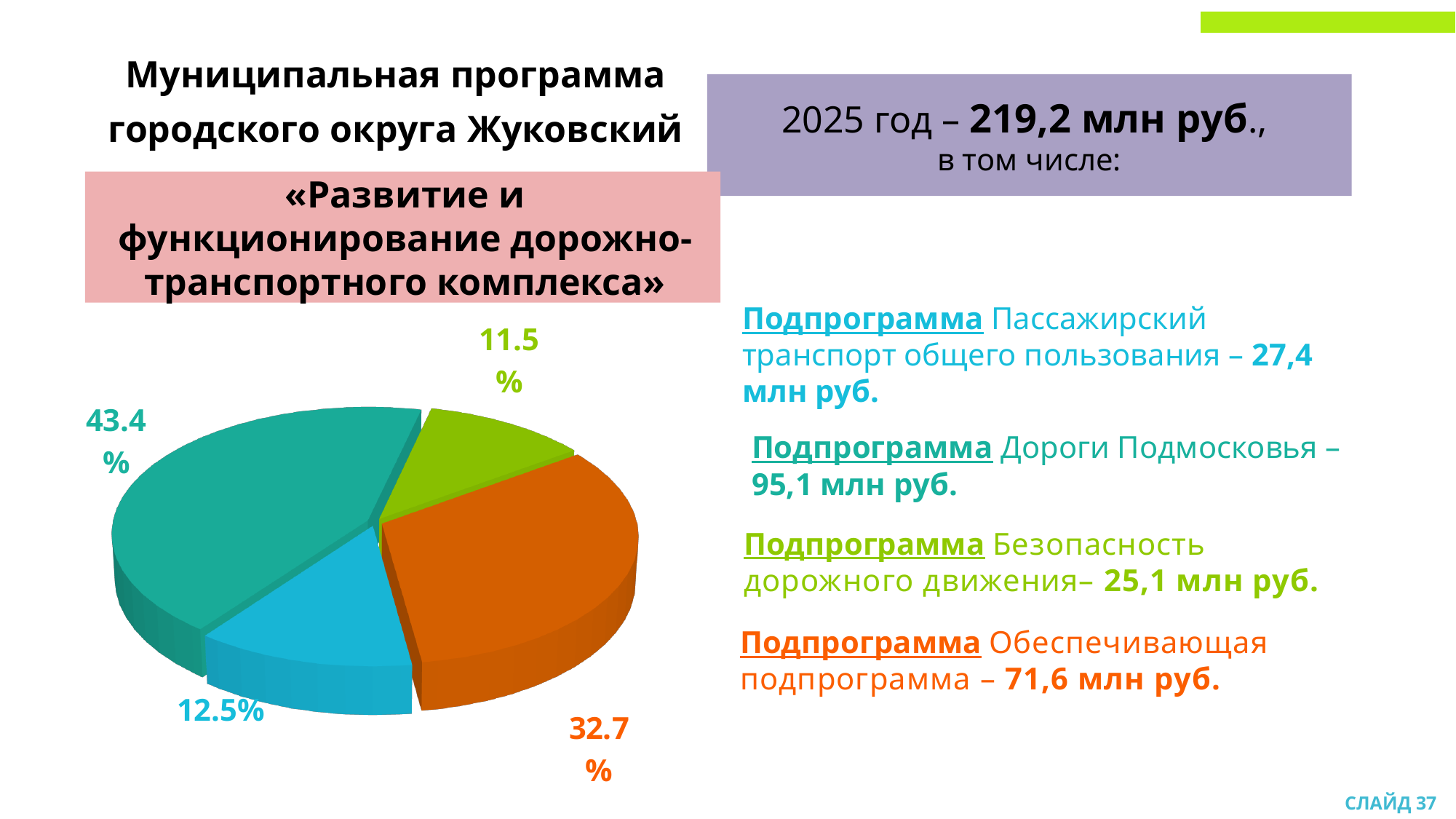
What percentage is shown for the green slice of the pie chart? 11.5% How many slices does the pie chart have? 4 What kind of chart is shown on the slide? pie chart What is the difference in percentage points between the largest slice (43.4%) and the orange slice (32.7%)? 10.7 According to the slide, what is the total programme budget for 2025 that the pie chart breaks down? 219,2 млн руб. What is the smallest share shown in the pie chart? 11.5% What percentage is shown for the light blue (cyan) slice of the pie chart? 12.5% What is the largest share shown in the pie chart? 43.4% Which subprogramme on the slide is shown in the same colour as the largest (teal) slice of the pie chart? Дороги Подмосковья Which slice is larger in the pie chart: the teal slice (43.4%) or the orange slice (32.7%)? the teal slice (43.4%) What percentage is shown for the orange slice of the pie chart? 32.7% What is the difference in percentage points between the 12.5% slice and the 11.5% slice? 1.0